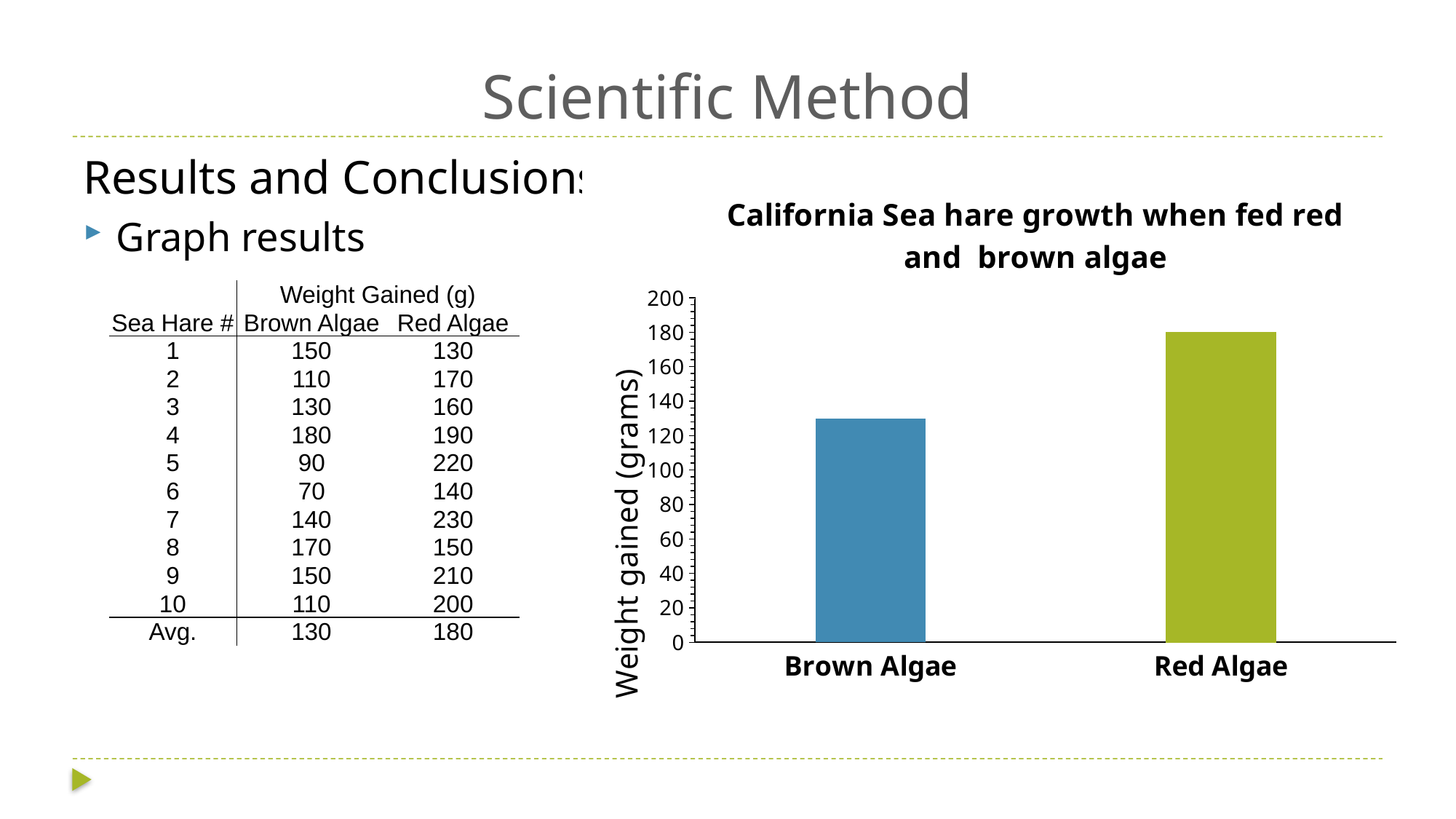
Is the value for Red Algae greater or less than 160? greater Which category has the highest weight gained in the chart? Red Algae Is the value for Brown Algae greater or less than 120? greater How many bars does the chart show? 2 Which category has the lowest weight gained in the chart? Brown Algae Is the value for Brown Algae greater or less than 140? less What is the title of the chart? California Sea hare growth when fed red and brown algae Which is larger in the chart, the value for Brown Algae or the value for Red Algae? Red Algae What is the maximum value shown on the vertical axis of the chart? 200 What kind of chart is shown on the slide? bar chart What is the label on the vertical axis of the chart? Weight gained (grams) What is the weight gained (grams) for Red Algae in the chart? 180